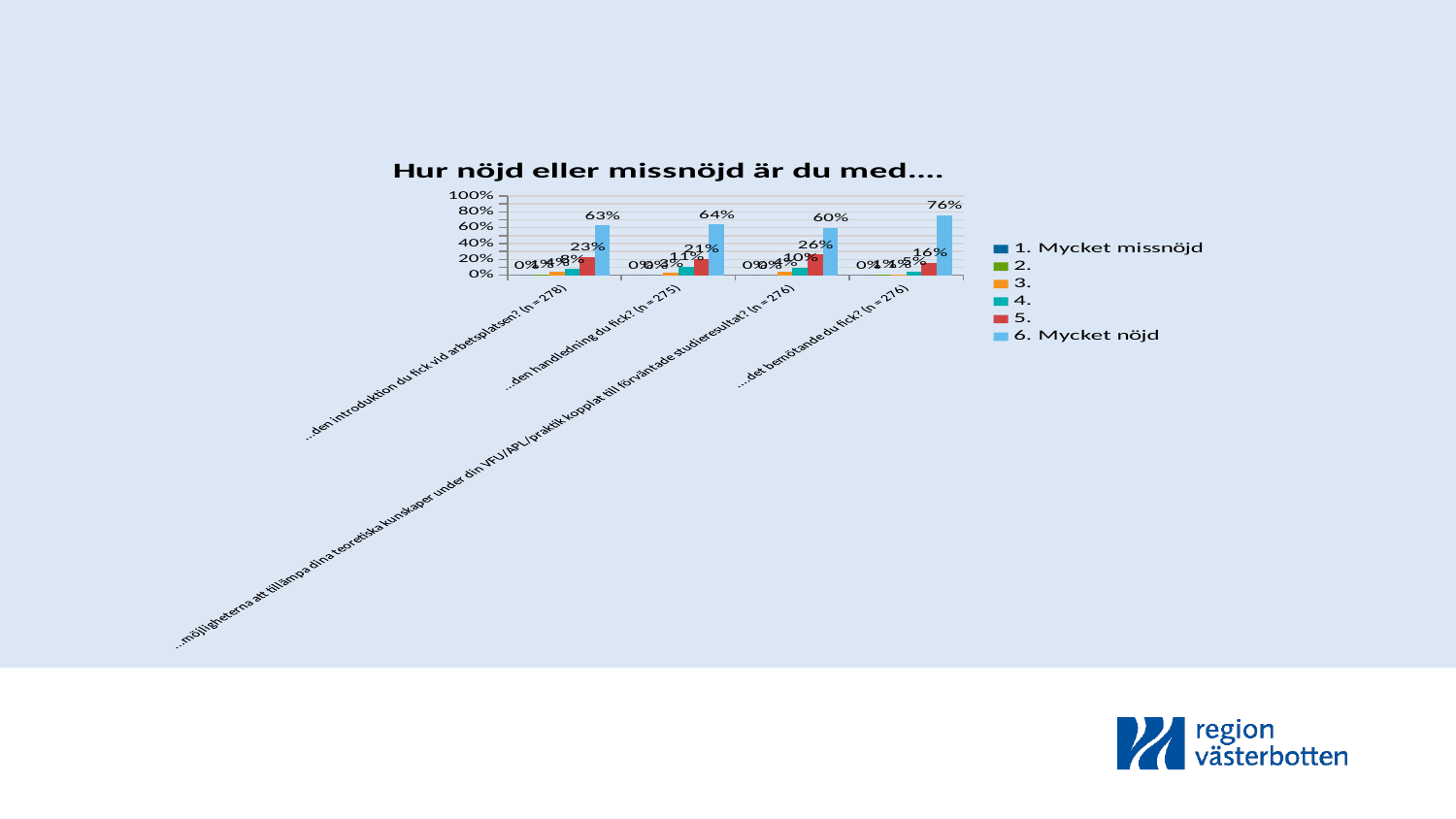
Which category has the highest value for '6. Mycket nöjd'? ...det bemötande du fick? (n=276) What is the value of '5.' for '...den handledning du fick? (n=275)'? 21% What is the chart's title? Hur nöjd eller missnöjd är du med.... What is the difference between the '6. Mycket nöjd' values for '...det bemötande du fick? (n=276)' and '...den handledning du fick? (n=275)'? 12% Which category has the lowest value for '6. Mycket nöjd'? ...möjligheterna att tillämpa dina teoretiska kunskaper under din VFU/APL/praktik kopplat till förväntade studieresultat? (n=276) How many series does the legend list? 6 What is the value of '6. Mycket nöjd' for '...det bemötande du fick? (n=276)'? 76% What is the value of '5.' for '...möjligheterna att tillämpa dina teoretiska kunskaper under din VFU/APL/praktik kopplat till förväntade studieresultat? (n=276)'? 26% Is the '6. Mycket nöjd' value for '...den handledning du fick? (n=275)' greater or less than 60%? greater What is the value of '6. Mycket nöjd' for '...den introduktion du fick vid arbetsplatsen? (n=278)'? 63% What kind of chart is shown on the slide? bar chart How many categories are shown on the x axis? 4